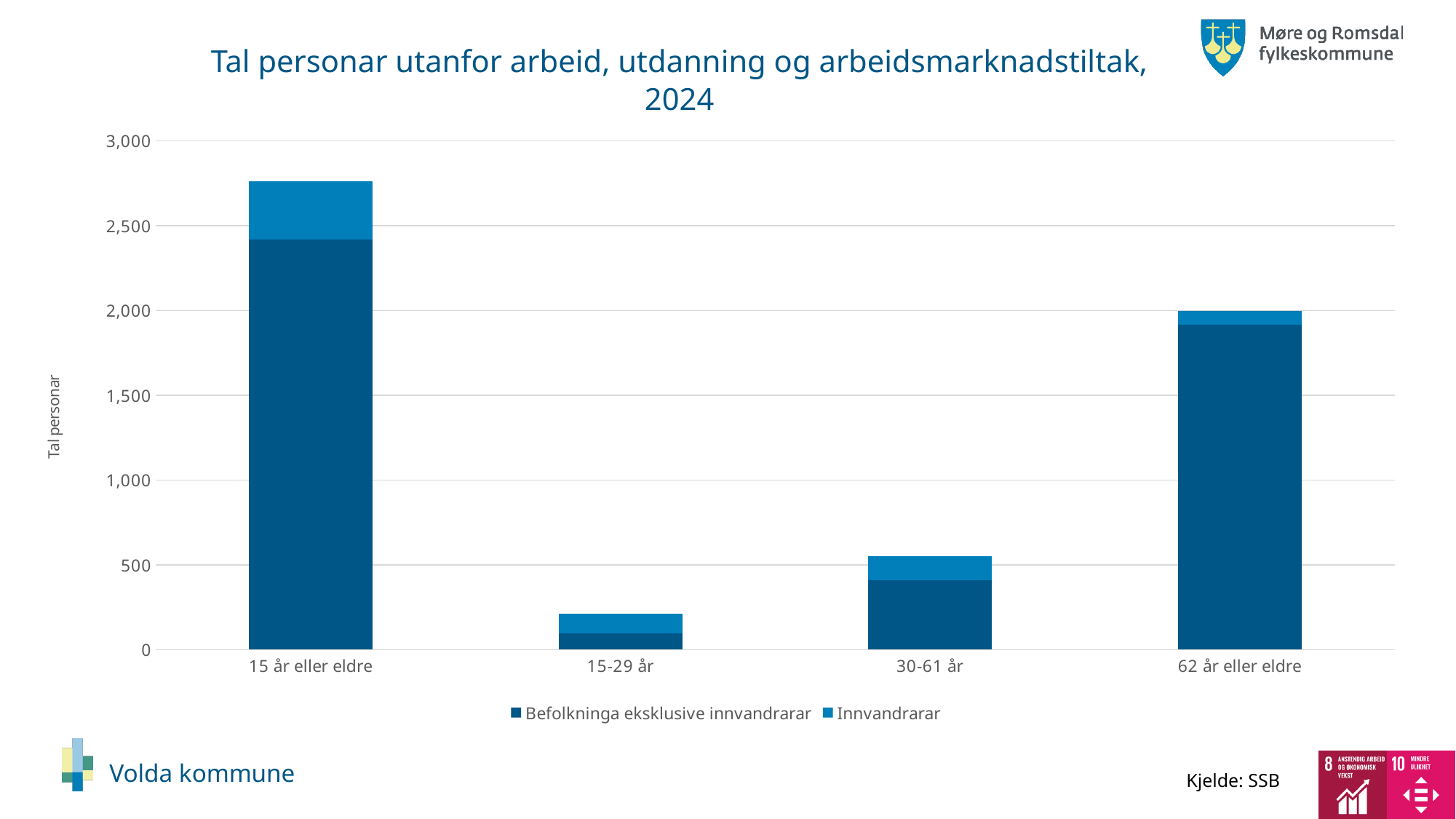
How many series does the legend list? 2 How many categories are shown on the x axis of the chart? 4 What is the label on the vertical axis of the chart? Tal personar Is the Befolkninga eksklusive innvandrarar value for 30-61 år greater or less than 500? less Is the total stacked bar for 62 år eller eldre greater or less than 1,500? greater Which category has the tallest stacked bar? 15 år eller eldre Is the total stacked bar for 15 år eller eldre greater or less than 2,500? greater Which stacked bar is taller, 62 år eller eldre or 30-61 år? 62 år eller eldre Which category has the shortest stacked bar? 15-29 år What kind of chart is shown on the slide? bar chart Which stacked bar is taller, 30-61 år or 15-29 år? 30-61 år